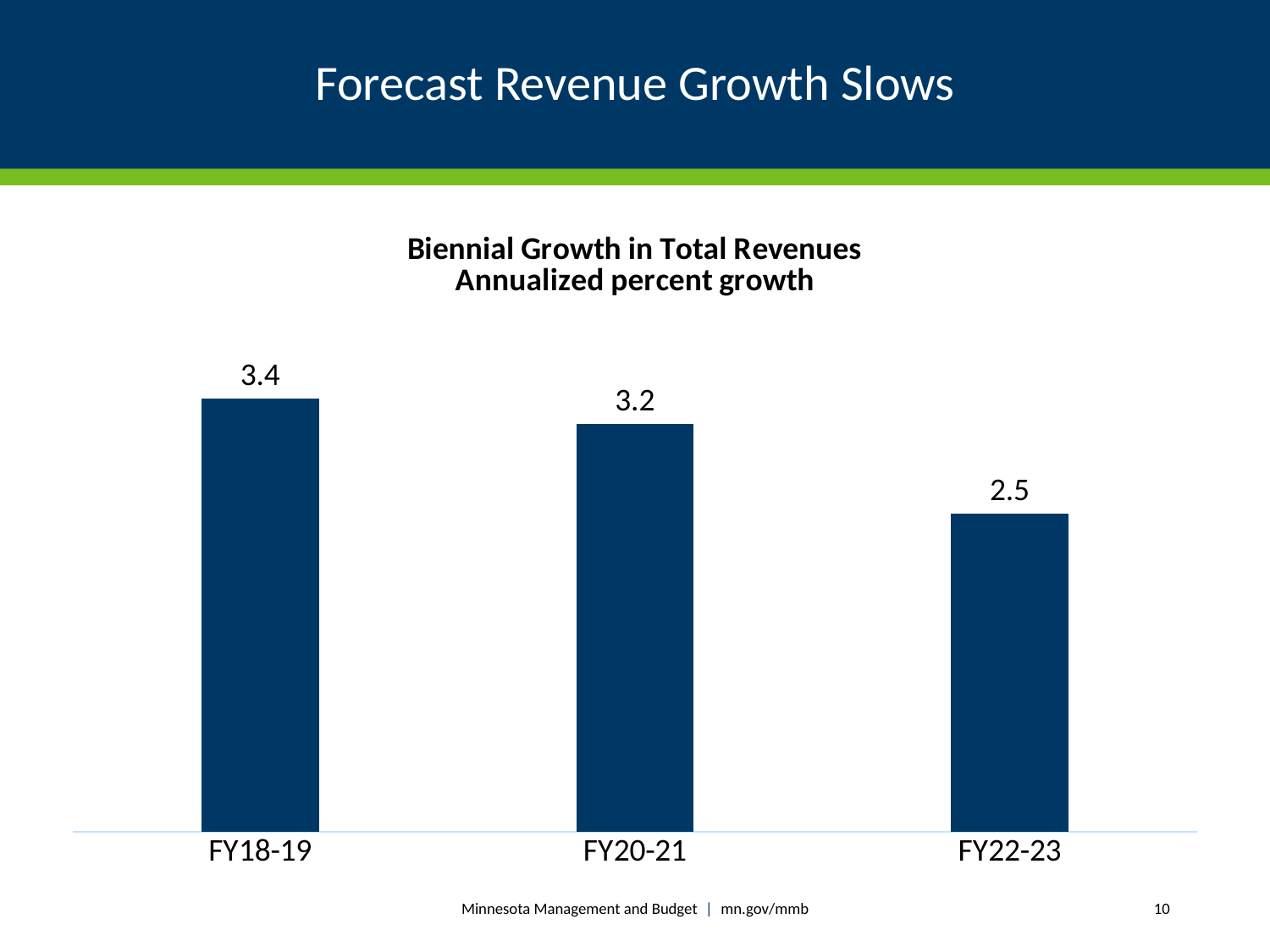
Which biennium has the lowest annualized percent growth? FY22-23 Which biennium has the highest annualized percent growth? FY18-19 How many bienniums are shown in the chart? 3 What is the annualized percent growth for FY22-23? 2.5 What is the annualized percent growth for FY18-19? 3.4 What is the difference between the growth for FY18-19 and FY22-23? 0.9 What is the annualized percent growth for FY20-21? 3.2 What kind of chart is shown on the slide? Bar chart Do the values rise or fall from FY18-19 to FY22-23? Fall Which is larger, the growth for FY20-21 or FY22-23? FY20-21 What is the title of the chart? Biennial Growth in Total Revenues What is the difference between the growth for FY20-21 and FY22-23? 0.7